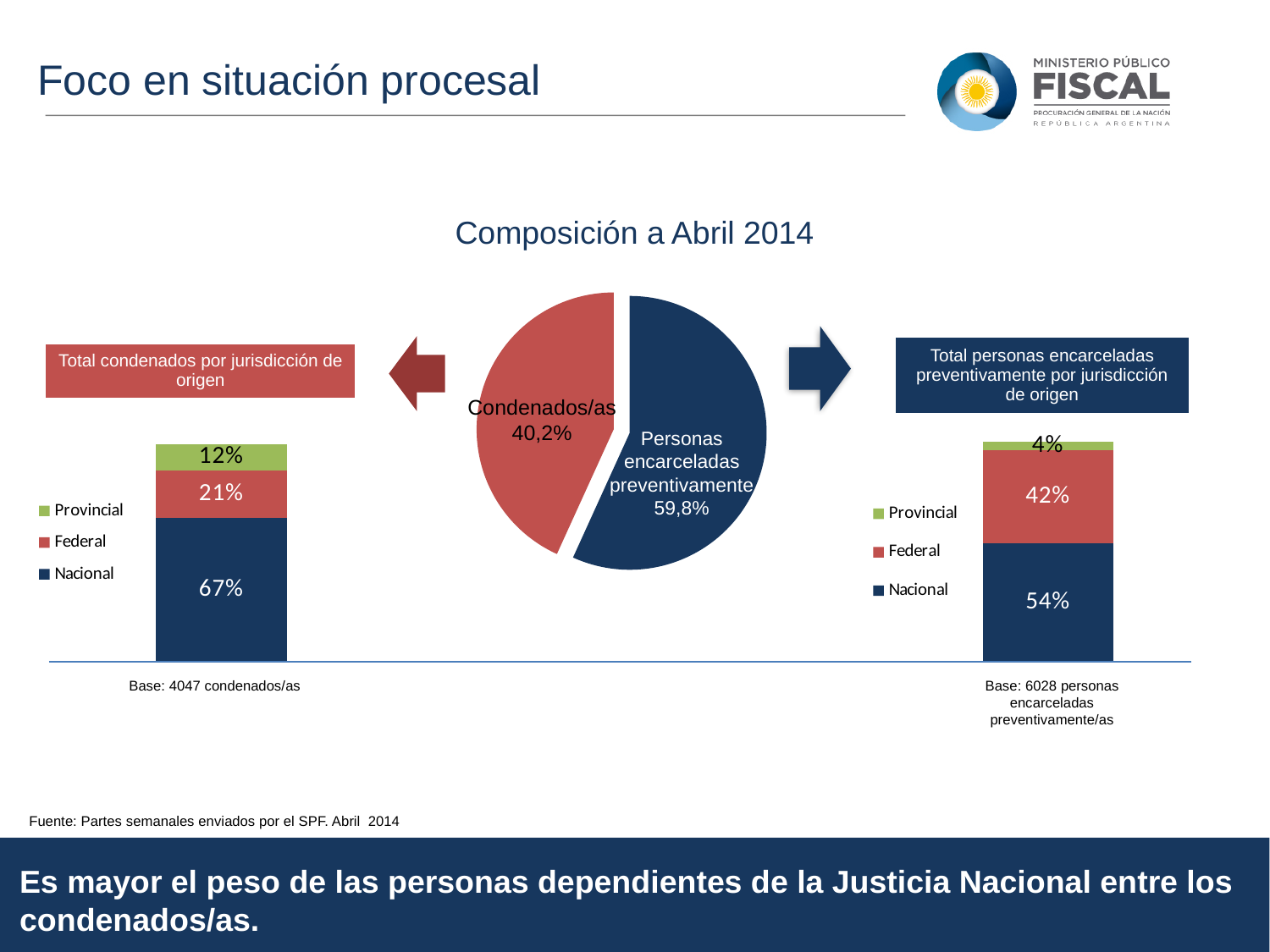
In the right chart 'Total personas encarceladas preventivamente por jurisdicción de origen', what is the value for Provincial? 4% In the right chart 'Total personas encarceladas preventivamente por jurisdicción de origen', what is the value for Federal? 42% In the right chart 'Total personas encarceladas preventivamente por jurisdicción de origen', which jurisdiction has the highest value? Nacional In the left chart 'Total condenados por jurisdicción de origen', which jurisdiction has the lowest value? Provincial In the pie chart 'Composición a Abril 2014', what share is labelled for Personas encarceladas preventivamente? 59,8% In the left chart 'Total condenados por jurisdicción de origen', what is the value for Federal? 21% How many series does the legend of the left chart 'Total condenados por jurisdicción de origen' list? 3 In the pie chart 'Composición a Abril 2014', what share is labelled for Condenados/as? 40,2% How many slices does the pie chart 'Composición a Abril 2014' have? 2 What is the difference between the Nacional value in the left chart (condenados) and the Nacional value in the right chart (encarcelados preventivamente)? 13 percentage points In the pie chart 'Composición a Abril 2014', which slice is larger, Condenados/as or Personas encarceladas preventivamente? Personas encarceladas preventivamente In the left chart 'Total condenados por jurisdicción de origen', what is the value for Nacional? 67%